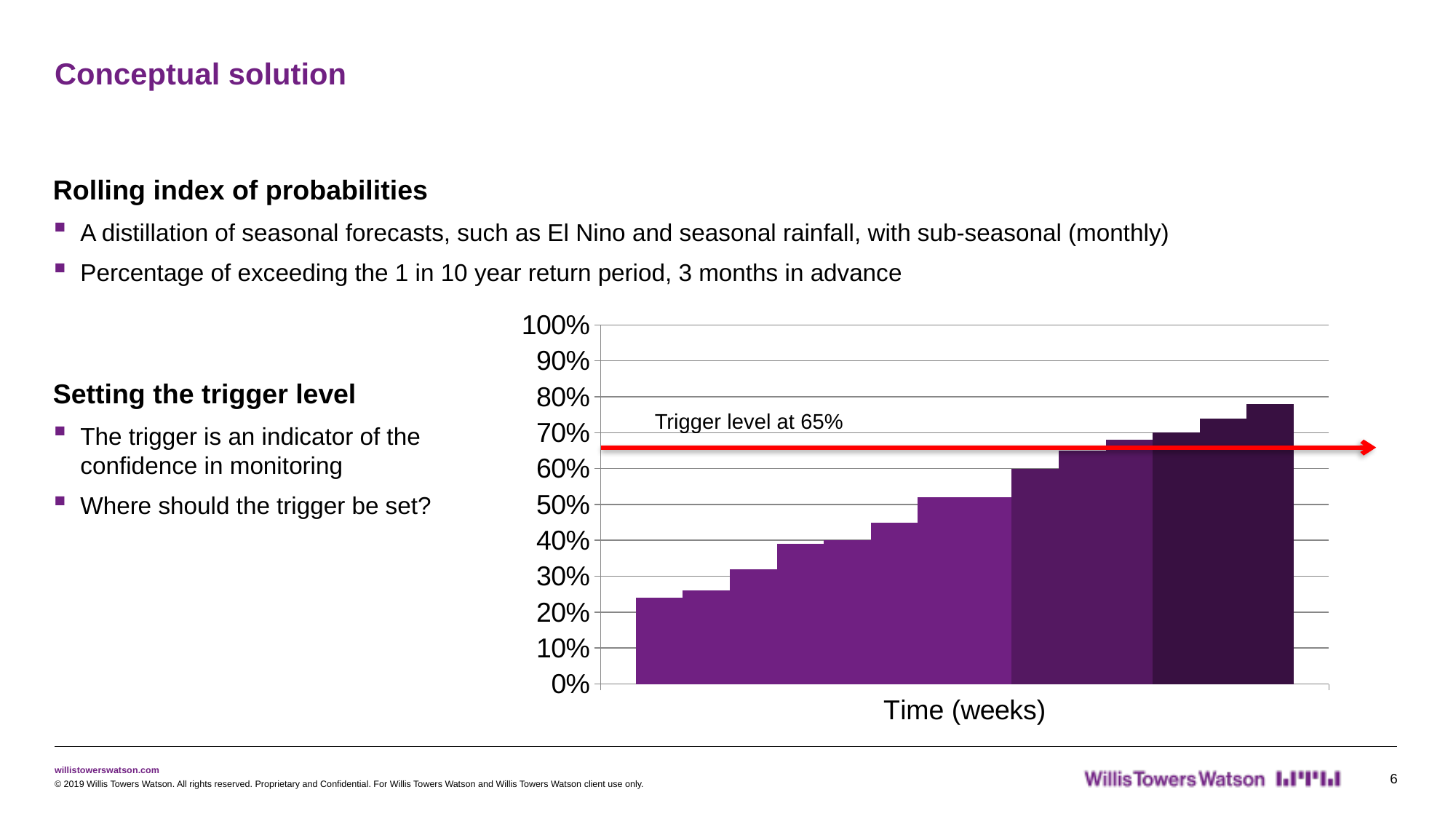
What is the maximum value shown on the y axis of the chart? 100% Is the value of the last (rightmost) bar greater or less than 70%? greater Is the value of the first (leftmost) bar greater or less than 30%? less Which bar is the tallest in the chart? The rightmost (last) bar Which bar is the shortest in the chart? The leftmost (first) bar What is the label of the x axis of the chart? Time (weeks) What kind of chart is shown on the slide? Bar chart Do the bar values rise or fall along the x axis (Time in weeks)? Rise Is the value of the first (leftmost) bar greater or less than 20%? greater Which is larger: the value of the leftmost bar or the value of the rightmost bar? The rightmost bar At what level is the trigger set, according to the annotation on the chart? 65%